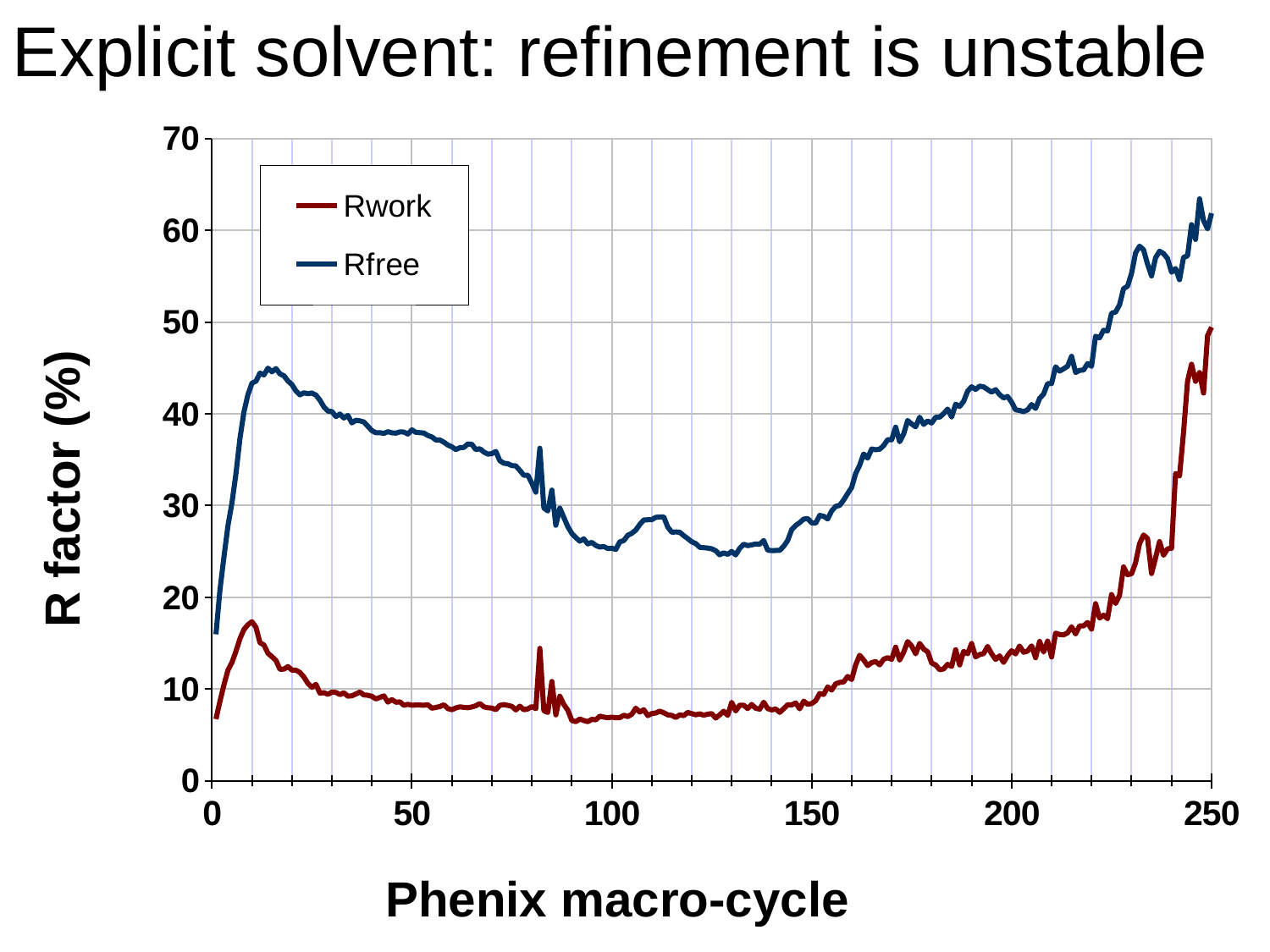
Does the Rfree series generally rise or fall between Phenix macro-cycle 150 and 250? rise What kind of chart is shown on the slide? line chart At Phenix macro-cycle 100, which series has the larger value, Rwork or Rfree? Rfree Is the Rfree value at Phenix macro-cycle 50 greater or less than 30? greater What are the two series named in the legend? Rwork and Rfree Is the Rwork value at Phenix macro-cycle 200 greater or less than 20? less Is the Rwork value at Phenix macro-cycle 100 greater or less than 10? less How many series does the legend list? 2 What is the label on the vertical axis? R factor (%) Does the Rwork series generally rise or fall between Phenix macro-cycle 10 and 50? fall